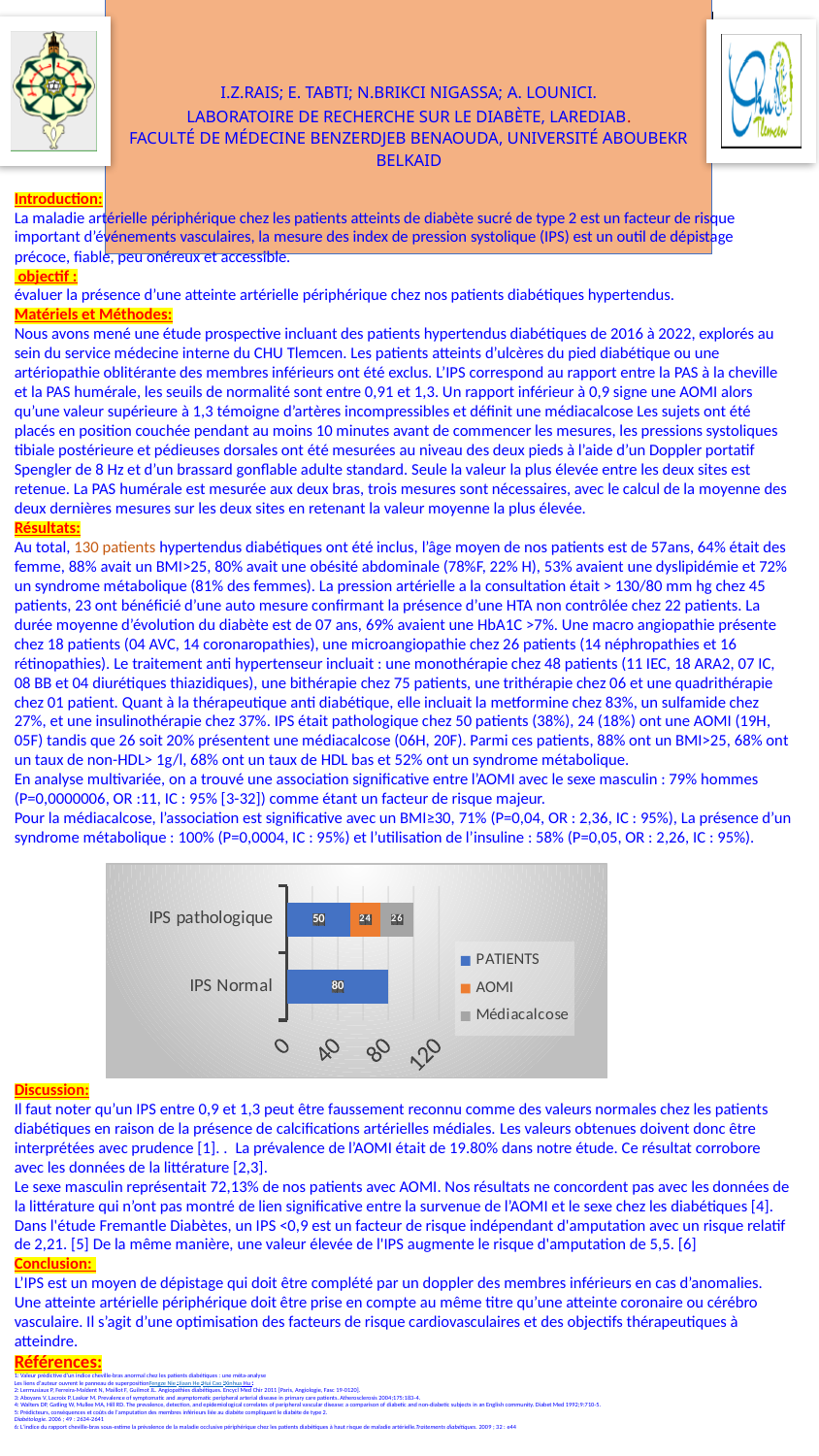
What is the PATIENTS value for IPS pathologique? 50 Which category has the higher PATIENTS value, IPS pathologique or IPS Normal? IPS Normal How many series does the chart legend list? 3 What is the Médiacalcose value for IPS pathologique? 26 What kind of chart is shown on the slide? Stacked bar chart What is the difference between the PATIENTS values for IPS Normal and IPS pathologique? 30 Is the PATIENTS value for IPS Normal greater or less than 40? greater Which legend entry is shown in orange? AOMI What is the PATIENTS value for IPS Normal? 80 How many categories are shown on the chart's vertical axis? 2 What is the total of the stacked bar for IPS pathologique? 100 What is the AOMI value for IPS pathologique? 24